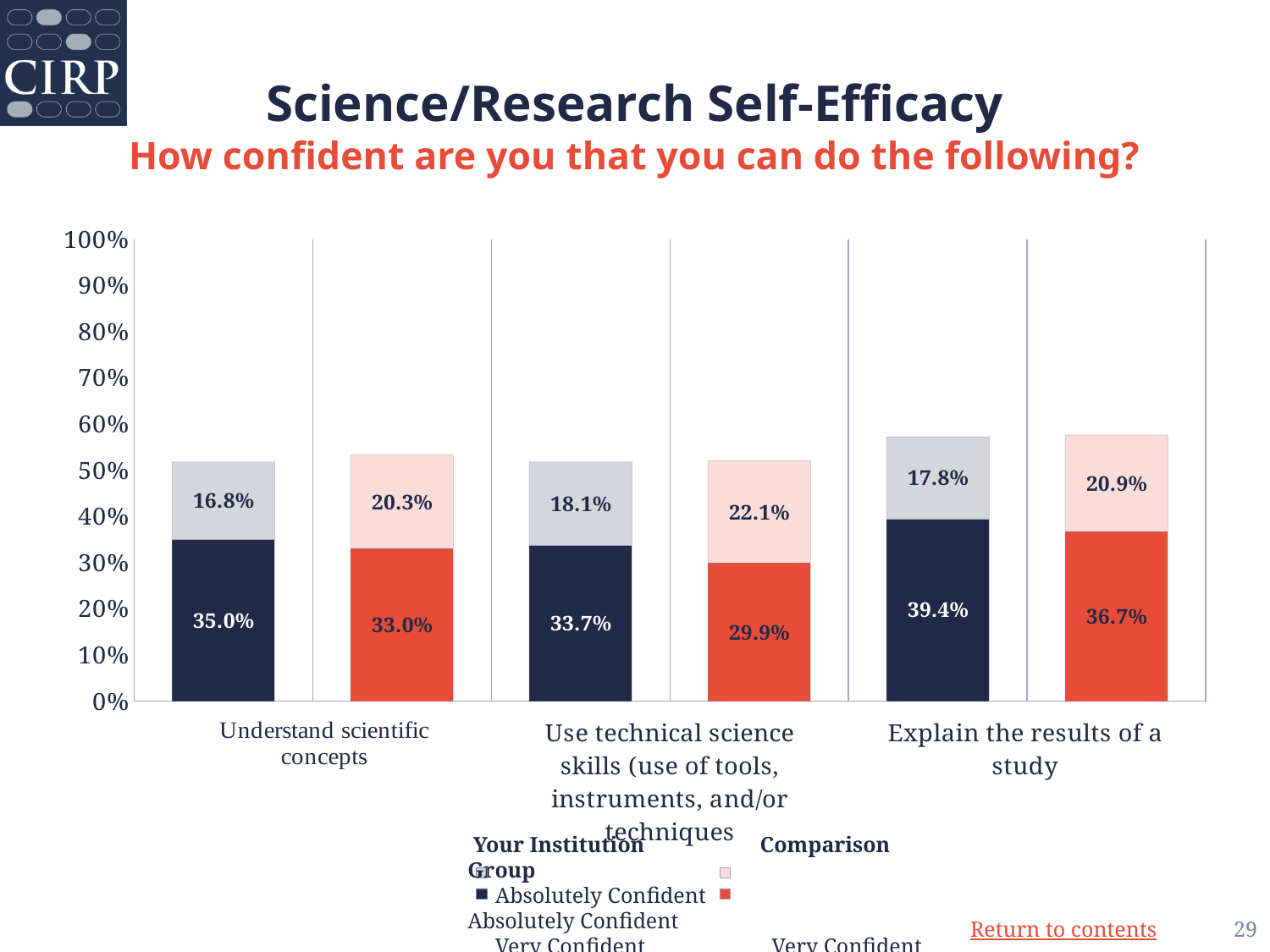
What is the Absolutely Confident value for the Comparison Group on 'Explain the results of a study'? 36.7% Is the total stacked bar for Your Institution on 'Use technical science skills' greater or less than 60%? less What is the combined total of the Comparison Group's stacked bar for 'Understand scientific concepts'? 53.3% What percentage of the Comparison Group is Very Confident they can use technical science skills? 22.1% For 'Understand scientific concepts', which group has the larger Very Confident percentage, Your Institution or the Comparison Group? Comparison Group What percentage of Your Institution respondents are Absolutely Confident they can understand scientific concepts? 35.0% Which item has the lowest Absolutely Confident percentage for the Comparison Group? Use technical science skills (use of tools, instruments, and/or techniques) How many survey items (categories) are shown on the x axis? 3 What type of chart is shown on the slide? Stacked bar chart What is the combined Absolutely Confident and Very Confident total for Your Institution on 'Explain the results of a study'? 57.2% What is the difference between Your Institution's and the Comparison Group's Absolutely Confident percentages for 'Use technical science skills'? 3.8% Across the three items, which has the highest Absolutely Confident percentage for Your Institution? Explain the results of a study